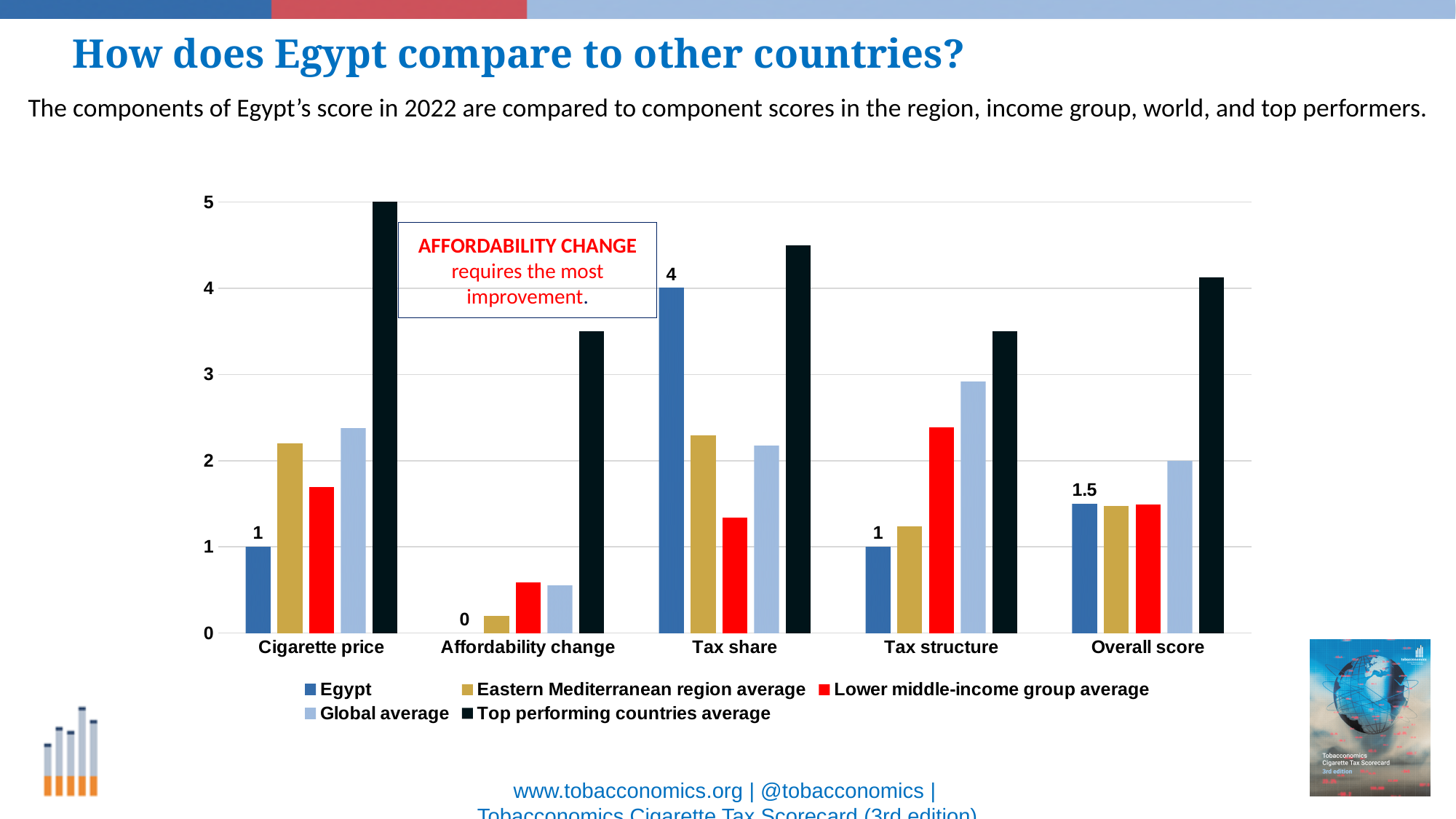
How many component categories are shown on the x axis? 5 What is Egypt's score for Cigarette price? 1 How many series does the legend list? 5 In which component does Egypt have its lowest score? Affordability change Which is larger for Egypt: the Tax share score or the Tax structure score? Tax share Is the Top performing countries average for Tax share greater or less than 4? greater What is Egypt's Overall score? 1.5 What is the difference between Egypt's Tax share score and its Cigarette price score? 3 What kind of chart is shown on the slide? bar chart What is Egypt's score for Affordability change? 0 What is Egypt's score for Tax share? 4 In which component does Egypt have its highest score? Tax share